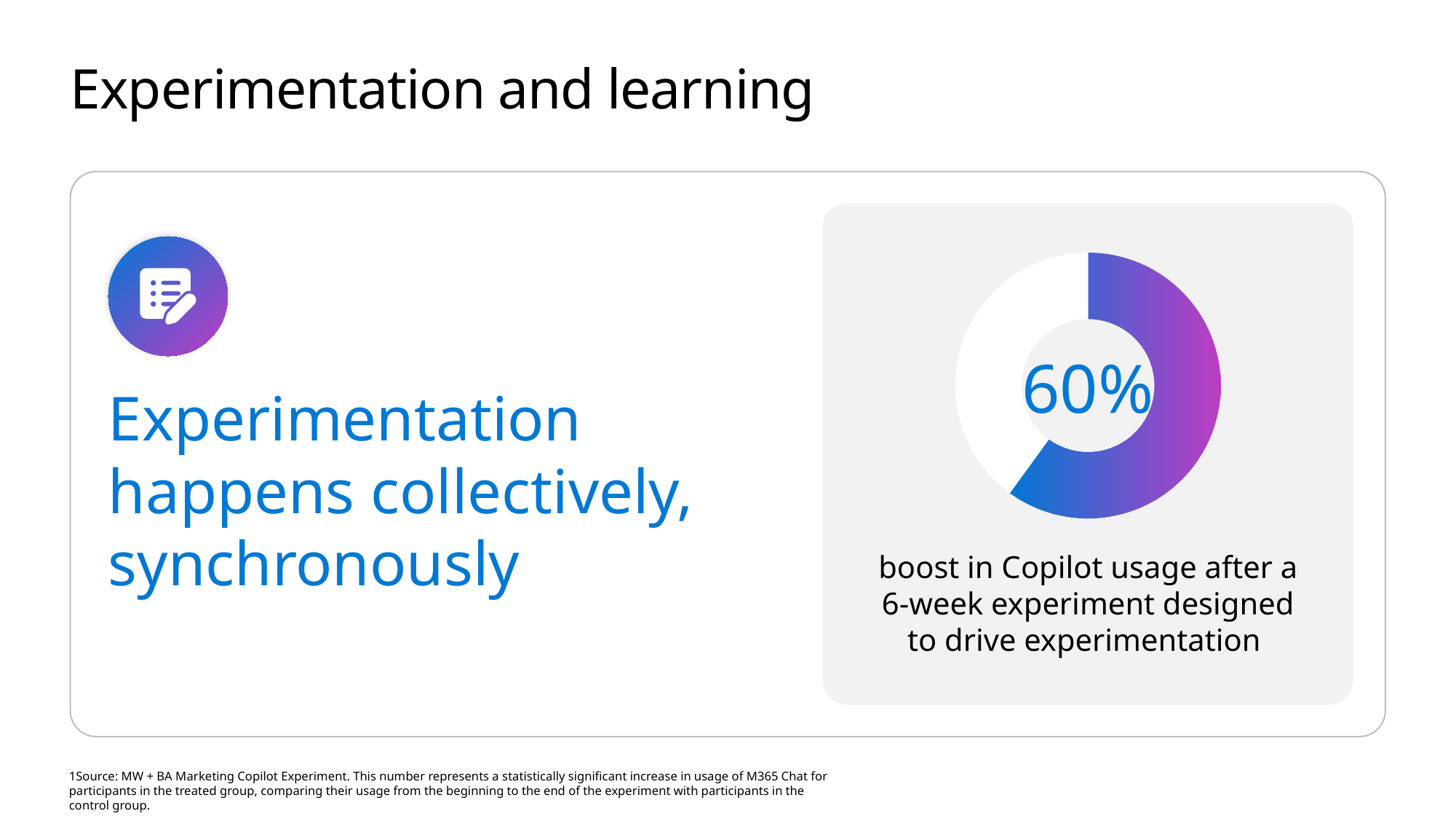
What kind of chart is shown on the right side of the slide? Donut chart According to the text below the donut chart, what does the 60% figure represent? Boost in Copilot usage after a 6-week experiment designed to drive experimentation How long was the experiment referred to by the donut chart? 6 weeks Is the value shown in the donut chart greater or less than 50%? greater What share of the donut chart is filled with the coloured segment? 60% Is the value shown in the donut chart greater or less than 75%? less What percentage is shown in the centre of the donut chart? 60%